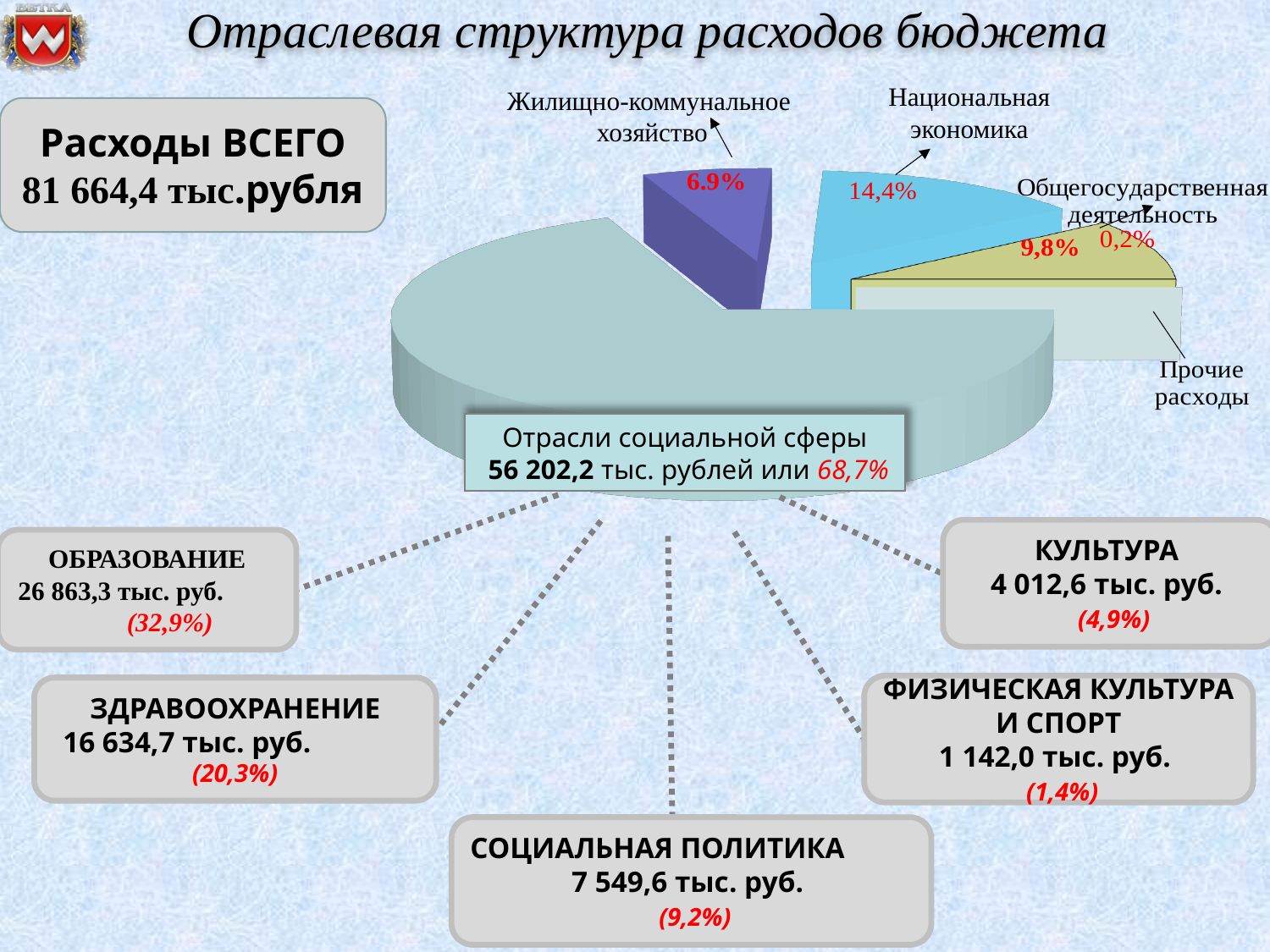
What share of expenditures does Образование account for according to the slide? 32,9% What percentage share do Отрасли социальной сферы have in the pie chart? 68,7% What is the difference in percentage points between Национальная экономика and Жилищно-коммунальное хозяйство? 7,5% What percentage share does Жилищно-коммунальное хозяйство have in the pie chart? 6.9% What amount is shown for Здравоохранение? 16 634,7 тыс. руб. What kind of chart is shown on the slide? pie chart What percentage share does Национальная экономика have in the pie chart? 14,4% What is the total budget expenditure (Расходы ВСЕГО) shown on the slide? 81 664,4 тыс. рубля Which slice of the pie chart is the largest? Отрасли социальной сферы What amount in thousand rubles is shown for Отрасли социальной сферы? 56 202,2 тыс. рублей What is the title of the slide's chart? Отраслевая структура расходов бюджета Which has a larger share: Национальная экономика or Жилищно-коммунальное хозяйство? Национальная экономика